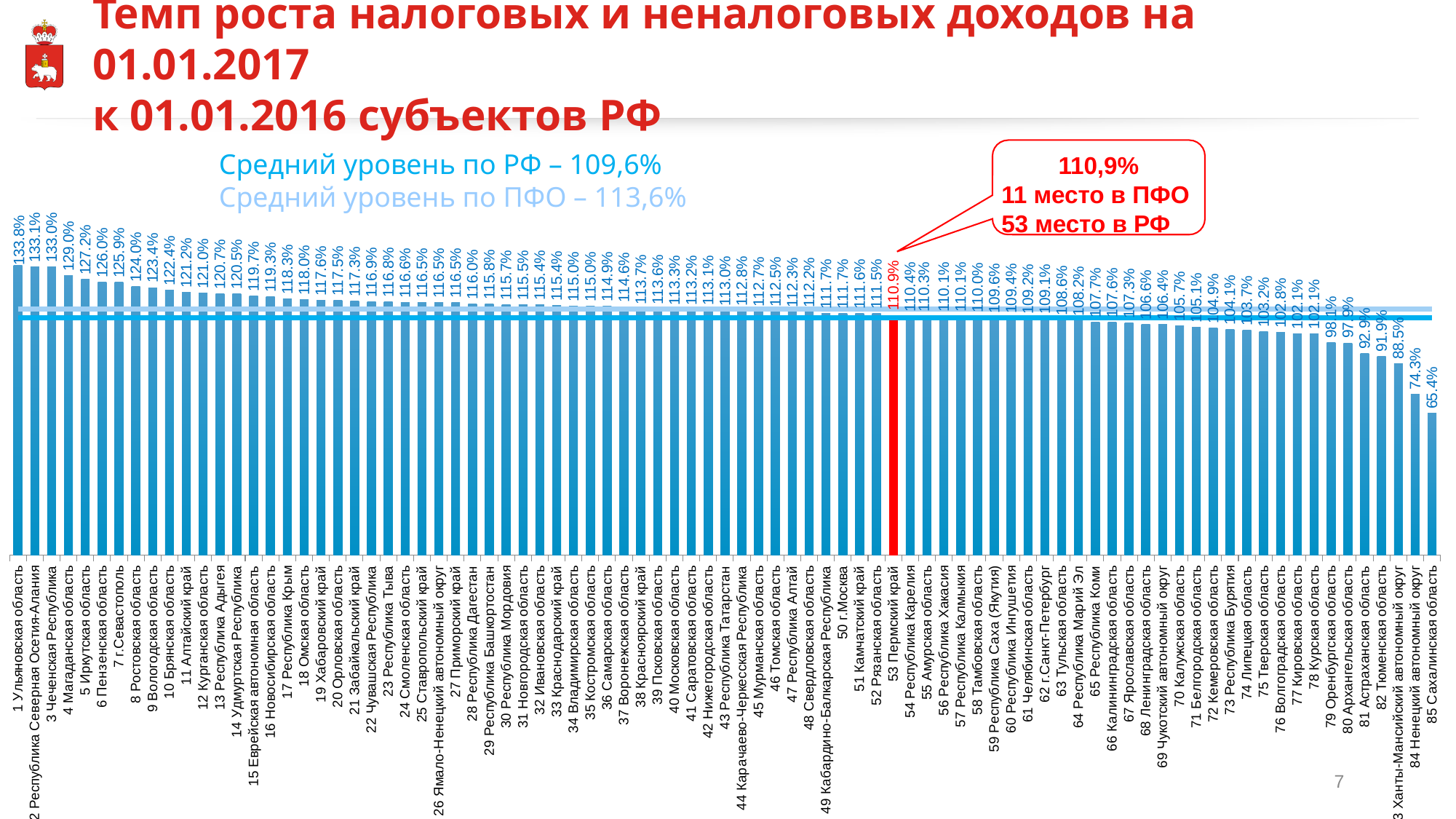
According to the slide, what is the average level for the Russian Federation (Средний уровень по РФ)? 109,6% Which region has the lowest value in the chart? Сахалинская область What is the difference between the values for Ульяновская область and Сахалинская область? 68.4 percentage points What is the value for Магаданская область? 129.0% Which is larger, the value for Иркутская область or the value for Тюменская область? Иркутская область What is the value for Ненецкий автономный округ? 74.3% Do the values rise or fall from left to right along the x axis? Fall What is the value for Пермский край? 110.9% What is the value for Сахалинская область? 65.4% How many regions (categories) are plotted in the chart? 85 What kind of chart is shown on the slide? Bar chart Which region has the highest value in the chart? Ульяновская область